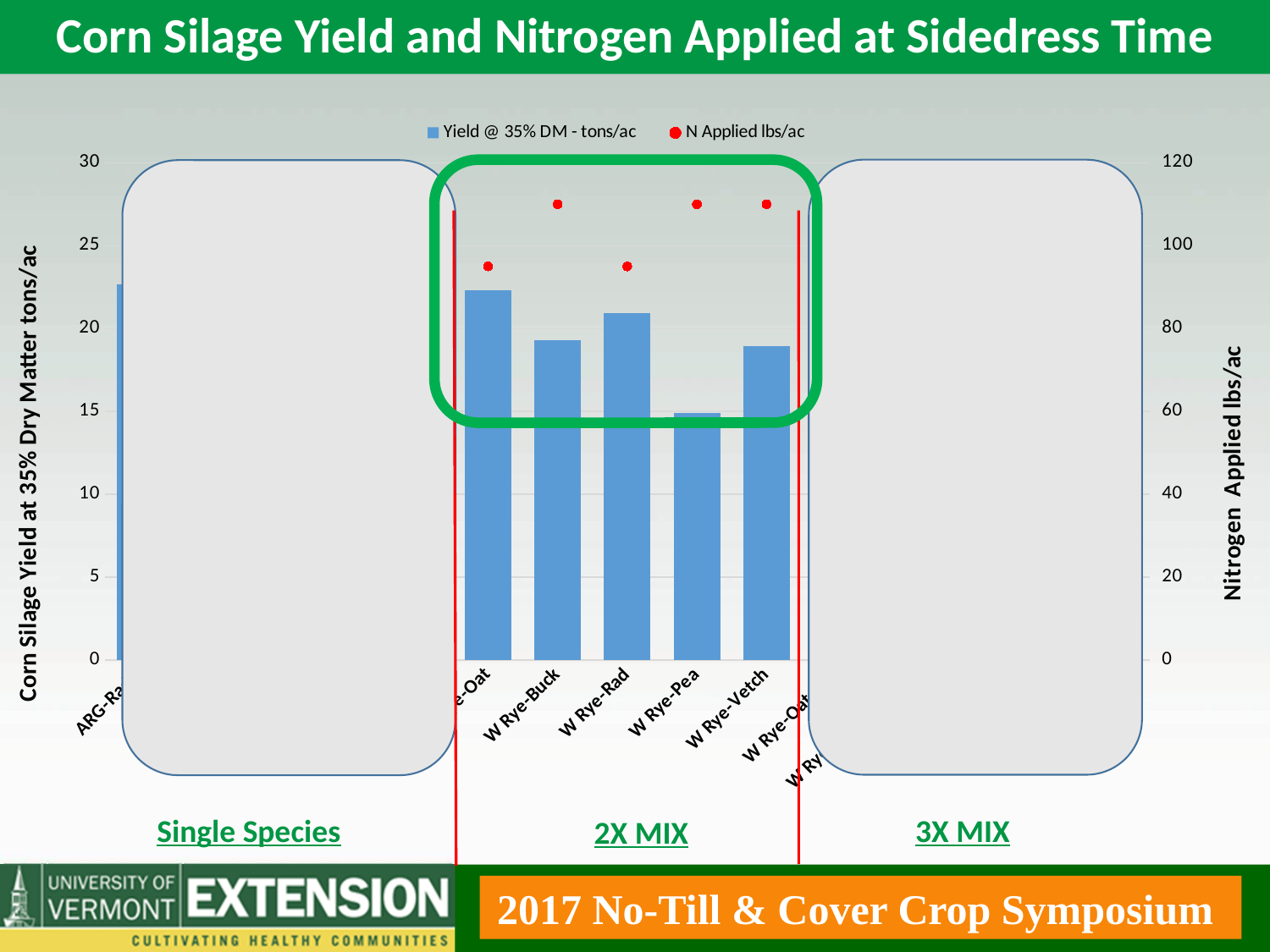
How many series does the chart legend list? 2 Which has the higher yield bar, W Rye-Rad or W Rye-Pea? W Rye-Rad Is the yield value for W Rye-Pea greater or less than 20 tons/ac? less What is the title of the chart on the slide? Corn Silage Yield and Nitrogen Applied at Sidedress Time Is the yield value for W Rye-Rad greater or less than 15 tons/ac? greater Is the N Applied value for W Rye-Buck greater or less than 100 lbs/ac? greater Which has the higher N Applied value, W Rye-Vetch or W Rye-Rad? W Rye-Vetch Which series in the legend is shown with red dots? N Applied lbs/ac What is the maximum value shown on the right-hand (Nitrogen Applied) axis? 120 Among the visible 2X MIX treatments, which has the lowest yield bar? W Rye-Pea